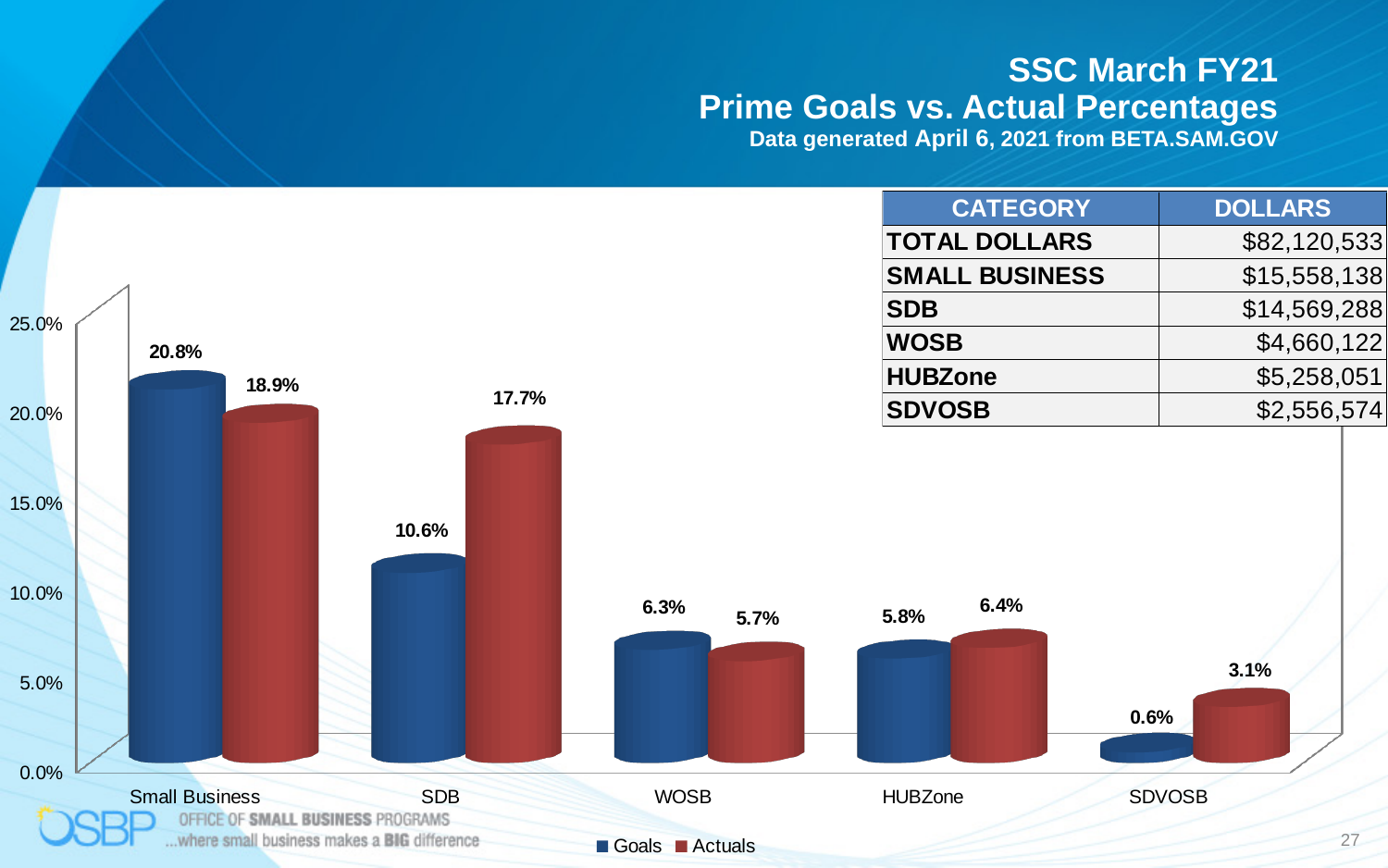
What is the Goals value for Small Business? 20.8% For WOSB, which is larger, the Goals value or the Actuals value? Goals How many series does the chart legend list? 2 Which category has the lowest Goals value? SDVOSB What is the difference between the Actuals and Goals values for SDB? 7.1% What is the Actuals value for SDVOSB? 3.1% What kind of chart is shown on the slide? Bar chart How many categories are shown on the x axis of the chart? 5 What is the Goals value for HUBZone? 5.8% Which colour represents the Actuals series in the chart? Red Which category has the highest Actuals value? Small Business What is the Actuals value for SDB? 17.7%